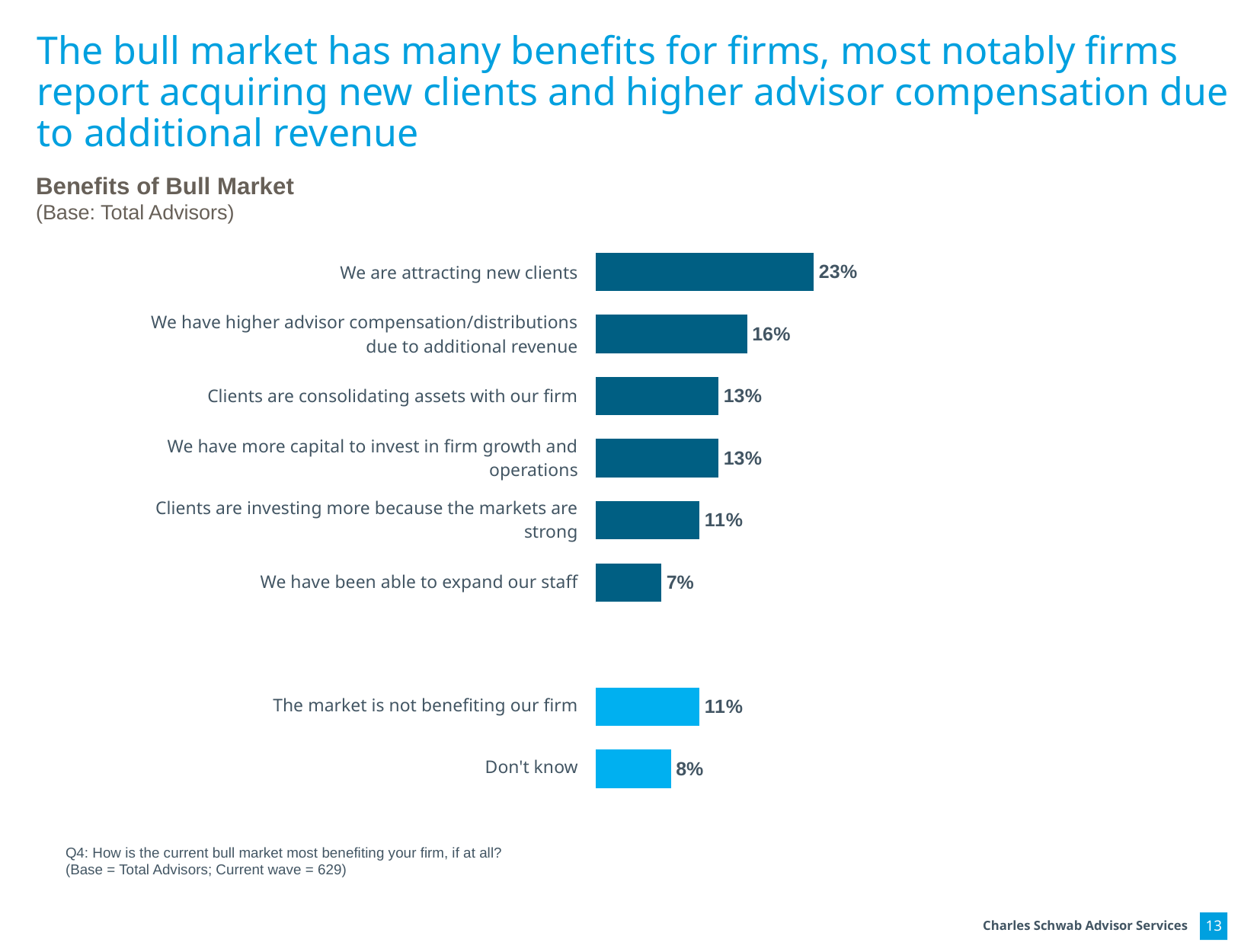
Which category has the lowest value? We have been able to expand our staff What is the value for "We have been able to expand our staff"? 7% Which is larger: "Clients are consolidating assets with our firm" or "Clients are investing more because the markets are strong"? Clients are consolidating assets with our firm What is the difference between "We are attracting new clients" and "We have higher advisor compensation/distributions due to additional revenue"? 7% What is the value for "Don't know"? 8% What kind of chart is shown on the slide? Bar chart How many categories are shown in the chart? 8 What is the difference between "The market is not benefiting our firm" and "Don't know"? 3% What is the title of the chart? Benefits of Bull Market Which category has the highest value? We are attracting new clients What percentage of advisors say they are attracting new clients? 23% What percentage of advisors say the market is not benefiting their firm? 11%